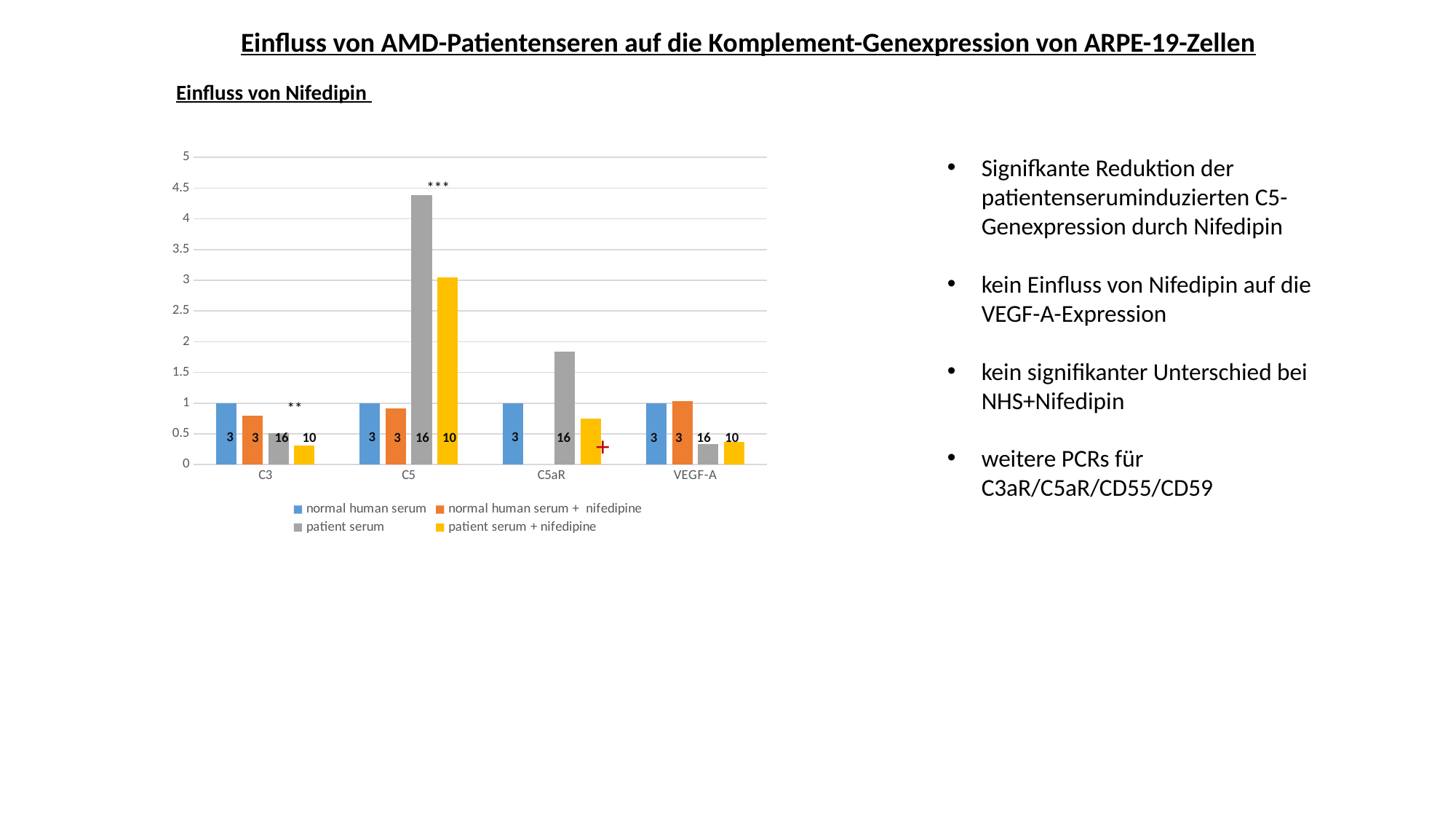
Which series is shown in yellow in the chart legend? patient serum + nifedipine How many categories are shown on the x axis of the chart? 4 What kind of chart is shown on the slide? bar chart Which category has the highest bar in the chart? C5 Which series has the highest bar in the C5aR category? patient serum Is the value for patient serum at VEGF-A greater or less than 0.5? less How many series does the chart legend list? 4 Is the value for patient serum + nifedipine at C3 greater or less than 0.5? less Which is larger: the patient serum value at C5 or the patient serum value at C5aR? C5 Is the value for patient serum at C5aR greater or less than 1.5? greater Which series has the lowest bar in the C3 category? patient serum + nifedipine